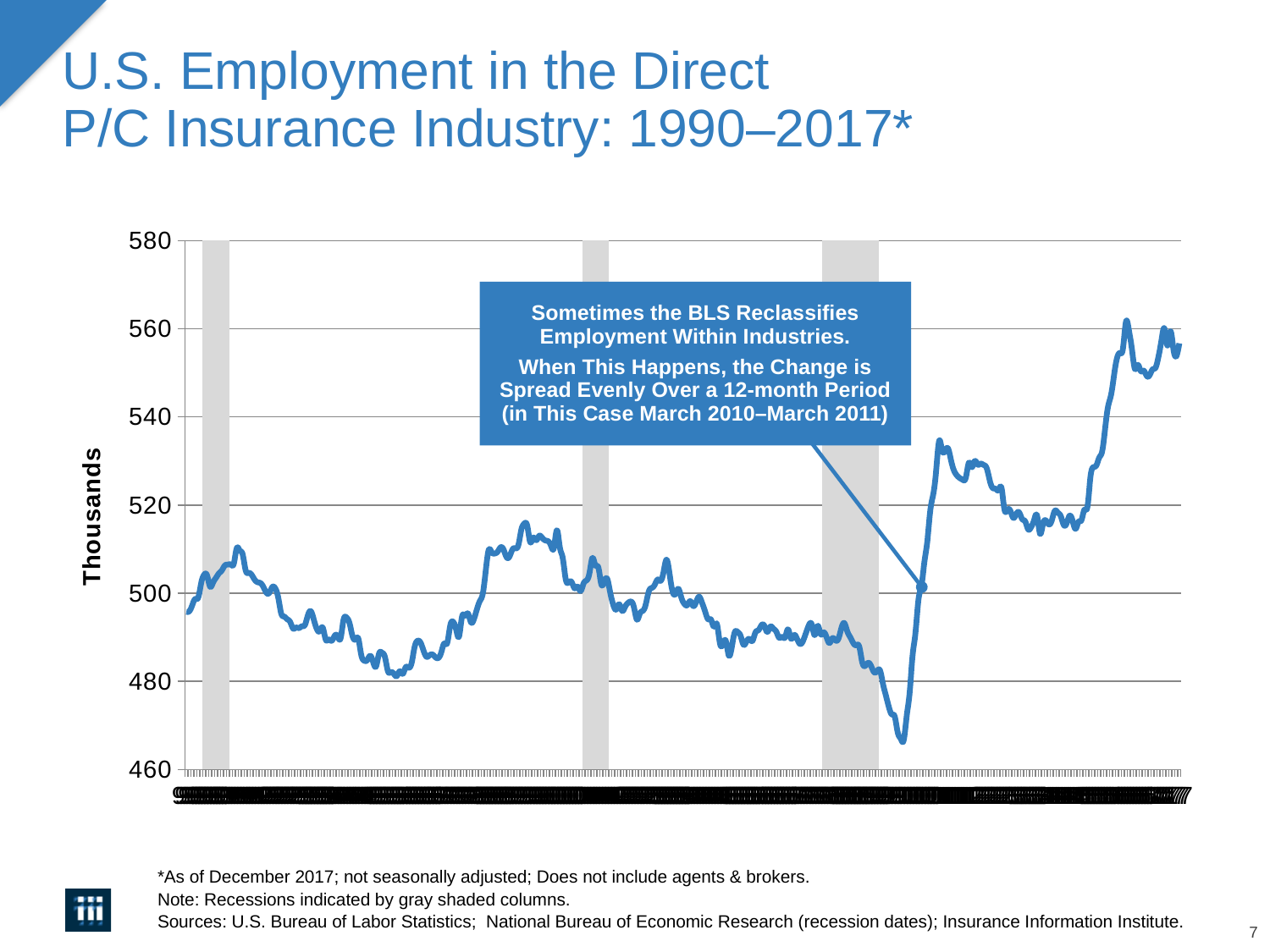
Is the highest point of the employment line greater or less than 540? greater Is the lowest point of the employment line greater or less than 460? greater What is the label on the vertical axis of the chart? Thousands Is the lowest point of the employment line greater or less than 480? less How many gray shaded recession columns appear on the chart? 3 What kind of chart is shown on the slide? line chart Which is higher: the value at the start of the series (1990) or at the end of the series (2017)? the end (2017) Overall, does the employment line rise or fall from the left end of the chart to the right end? rise